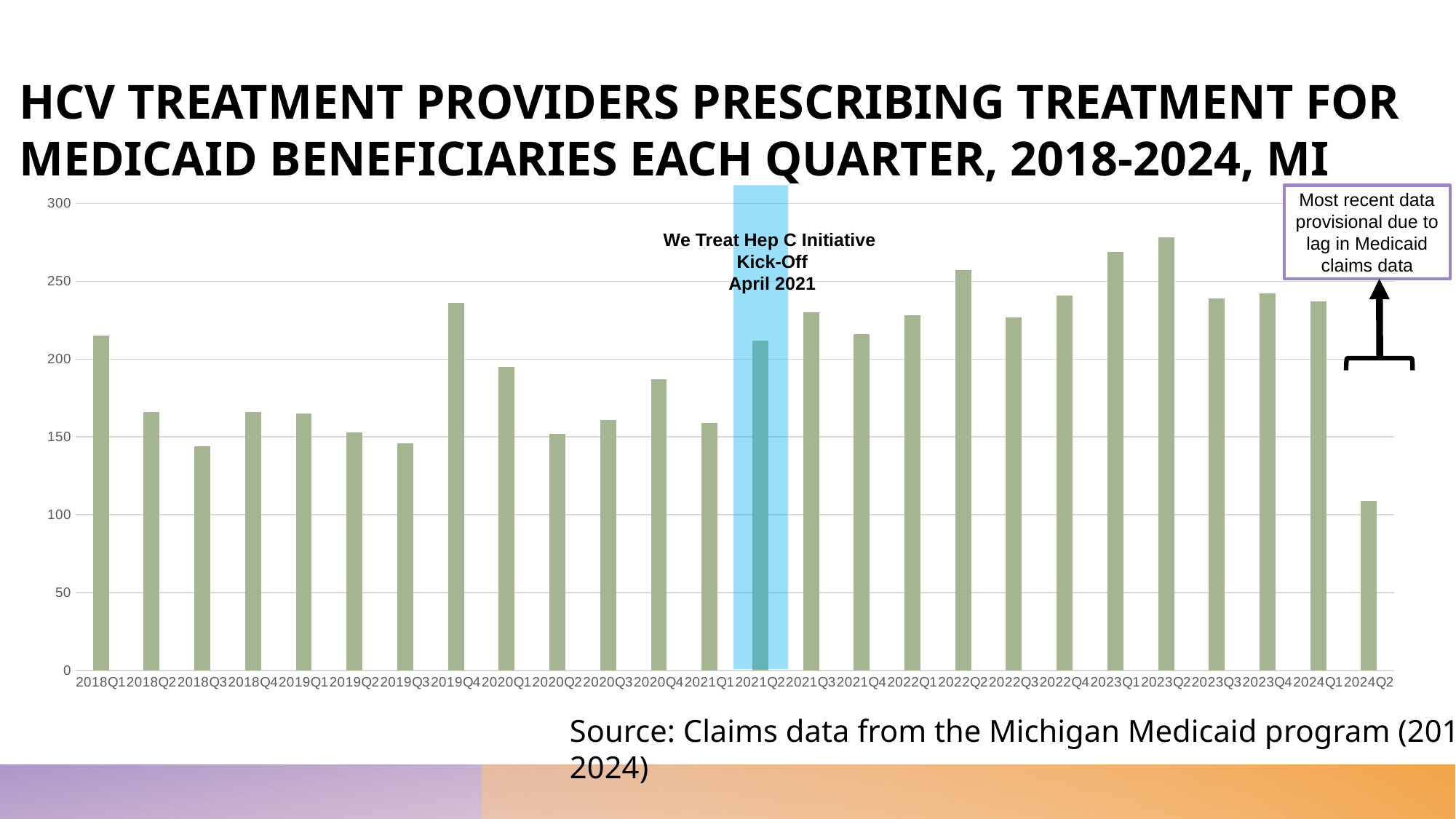
Which quarter has the lowest number of HCV treatment providers? 2024Q2 What kind of chart is shown on the slide? Bar chart Is the value for 2018Q1 greater or less than 200? greater Which quarter is highlighted with a blue shaded band on the chart? 2021Q2 Which is larger, the value for 2019Q4 or the value for 2019Q3? 2019Q4 Is the value for 2018Q3 greater or less than 150? less Is the value for 2023Q2 greater or less than 250? greater How many quarters are plotted on the x axis? 26 What event does the annotation above the highlighted bar mark? We Treat Hep C Initiative Kick-Off April 2021 Which quarter has the highest number of HCV treatment providers? 2023Q2